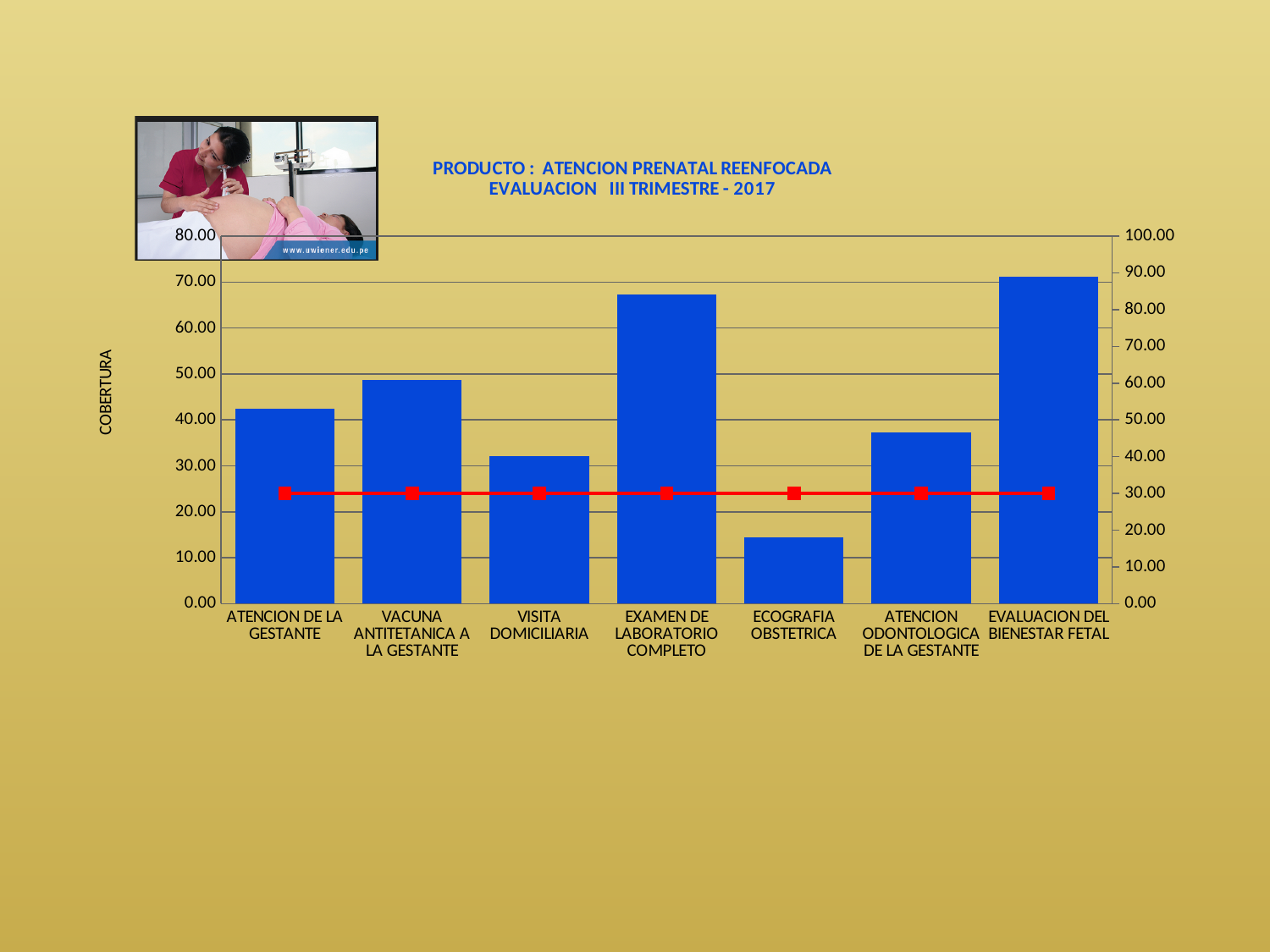
Which bar is taller: VACUNA ANTITETANICA A LA GESTANTE or ATENCION ODONTOLOGICA DE LA GESTANTE? VACUNA ANTITETANICA A LA GESTANTE What is the label on the vertical axis of the chart? COBERTURA Is the value for ECOGRAFIA OBSTETRICA greater or less than 20.00? less What kind of chart is shown on the slide? combination bar and line chart Which bar is taller: EXAMEN DE LABORATORIO COMPLETO or VISITA DOMICILIARIA? EXAMEN DE LABORATORIO COMPLETO Is the value for EXAMEN DE LABORATORIO COMPLETO greater or less than 60.00? greater Which category has the lowest bar in the chart? ECOGRAFIA OBSTETRICA What is the title of the chart? PRODUCTO : ATENCION PRENATAL REENFOCADA EVALUACION III TRIMESTRE - 2017 Is the value for VACUNA ANTITETANICA A LA GESTANTE greater or less than 40.00? greater How many categories are shown along the x axis of the chart? 7 Does the red line rise, fall, or stay flat across the categories? stays flat Which category has the highest bar in the chart? EVALUACION DEL BIENESTAR FETAL